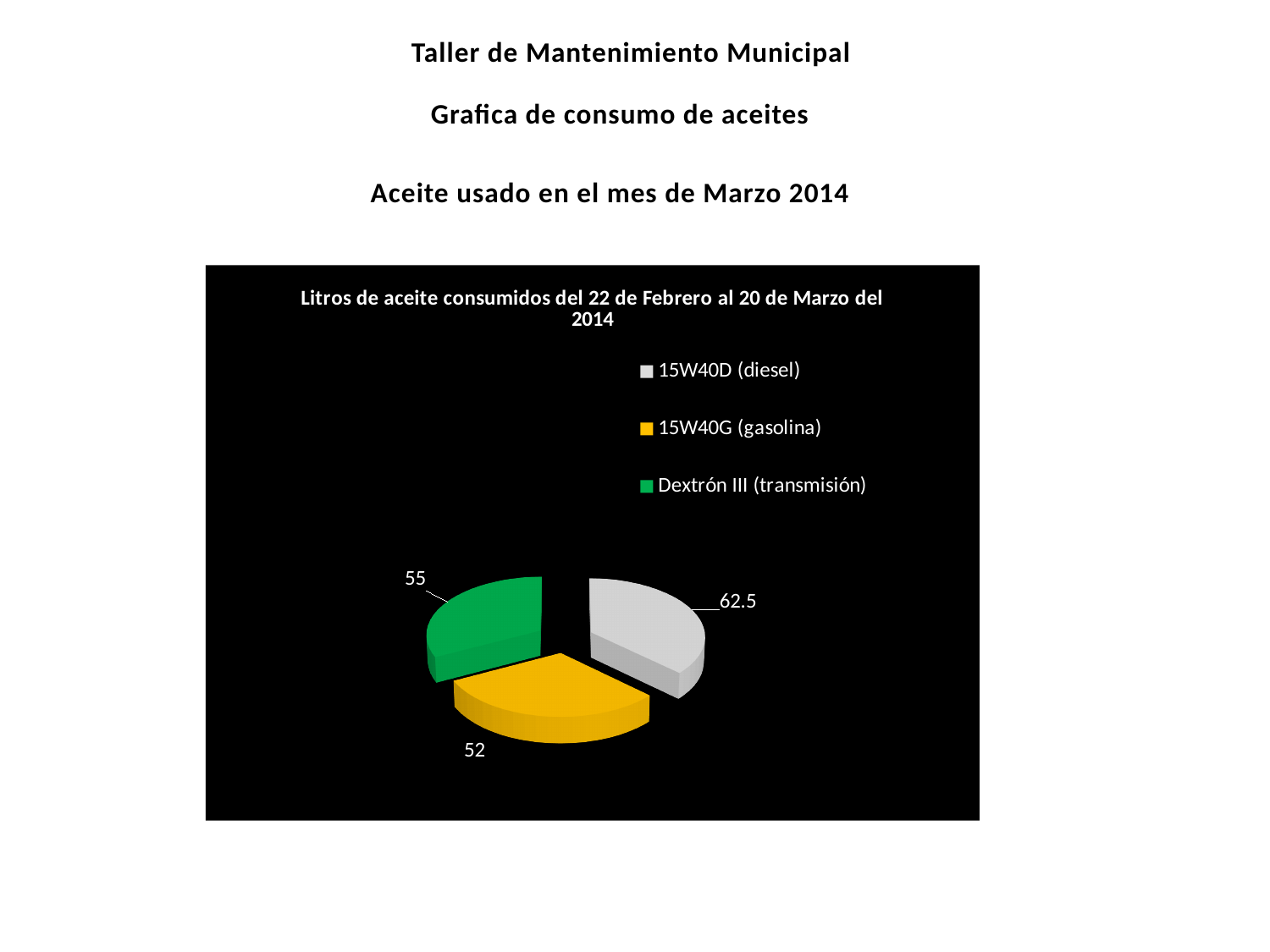
Which oil type has the lowest value? 15W40G (gasolina) What is the value for Dextrón III (transmisión)? 55 What is the difference between the values for 15W40D (diesel) and 15W40G (gasolina)? 10.5 What is the title of the chart? Litros de aceite consumidos del 22 de Febrero al 20 de Marzo del 2014 What is the value for 15W40G (gasolina)? 52 What is the value for 15W40D (diesel)? 62.5 What type of chart is shown on the slide? Pie chart Which is larger, the value for Dextrón III (transmisión) or the value for 15W40G (gasolina)? Dextrón III (transmisión) How many slices does the pie chart have? 3 Which oil type has the highest value? 15W40D (diesel) What colour is the slice for 15W40G (gasolina)? Yellow What is the difference between the values for Dextrón III (transmisión) and 15W40G (gasolina)? 3